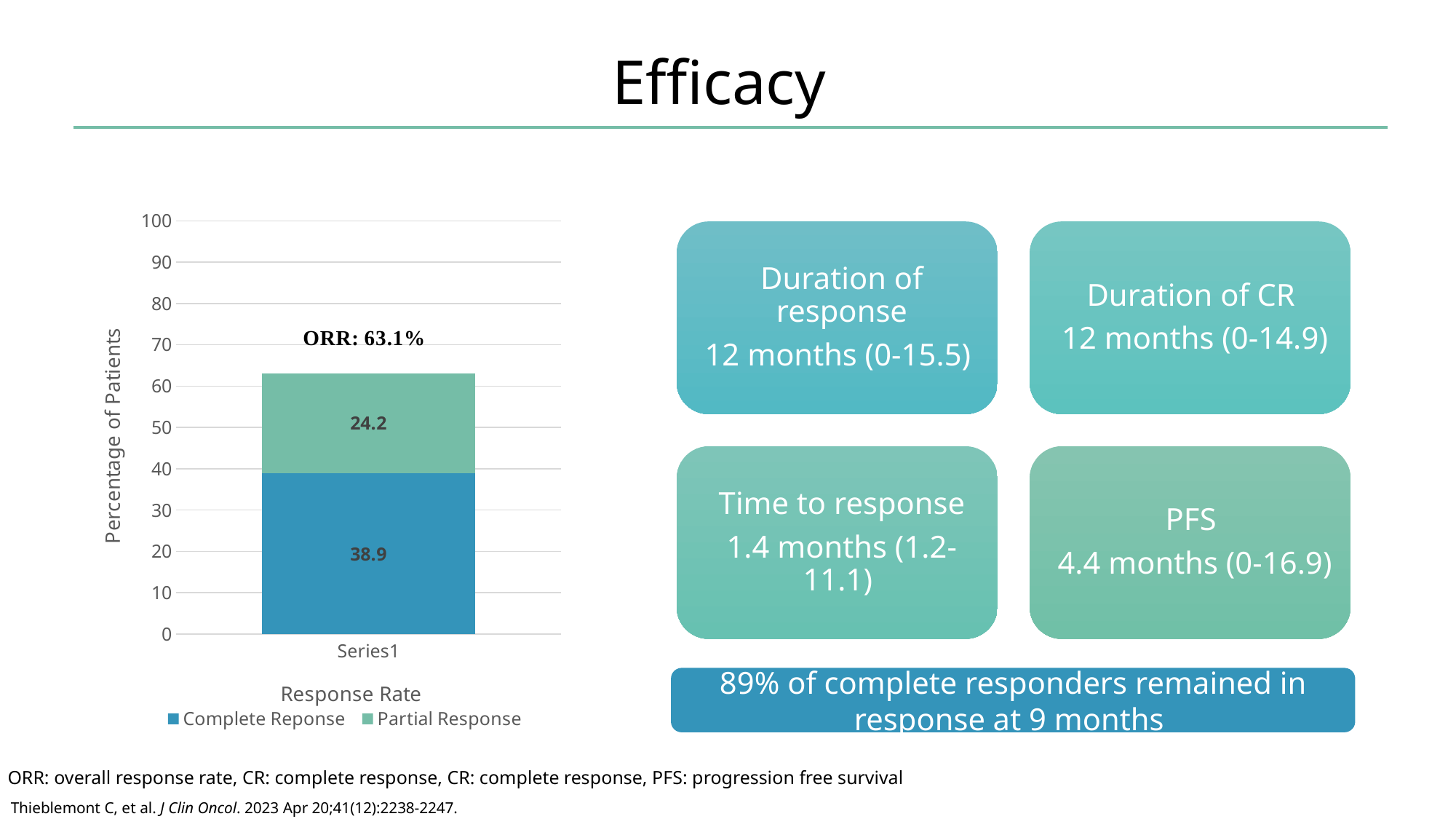
What is the difference between the Complete Reponse value and the Partial Response value? 14.7 What is the total of the stacked bar for Series1? 63.1 Which series has the larger value, Complete Reponse or Partial Response? Complete Reponse Is the Complete Reponse value greater or less than 30? greater What kind of chart is shown on the slide? Stacked bar chart What is the value for Partial Response in the chart? 24.2 How many bars are plotted in the chart? 1 What ORR value is annotated above the bar? 63.1% How many series does the legend list? 2 What is the value for Complete Reponse in the chart? 38.9 Is the total height of the stacked bar greater or less than 70? less What is the label of the vertical axis of the chart? Percentage of Patients